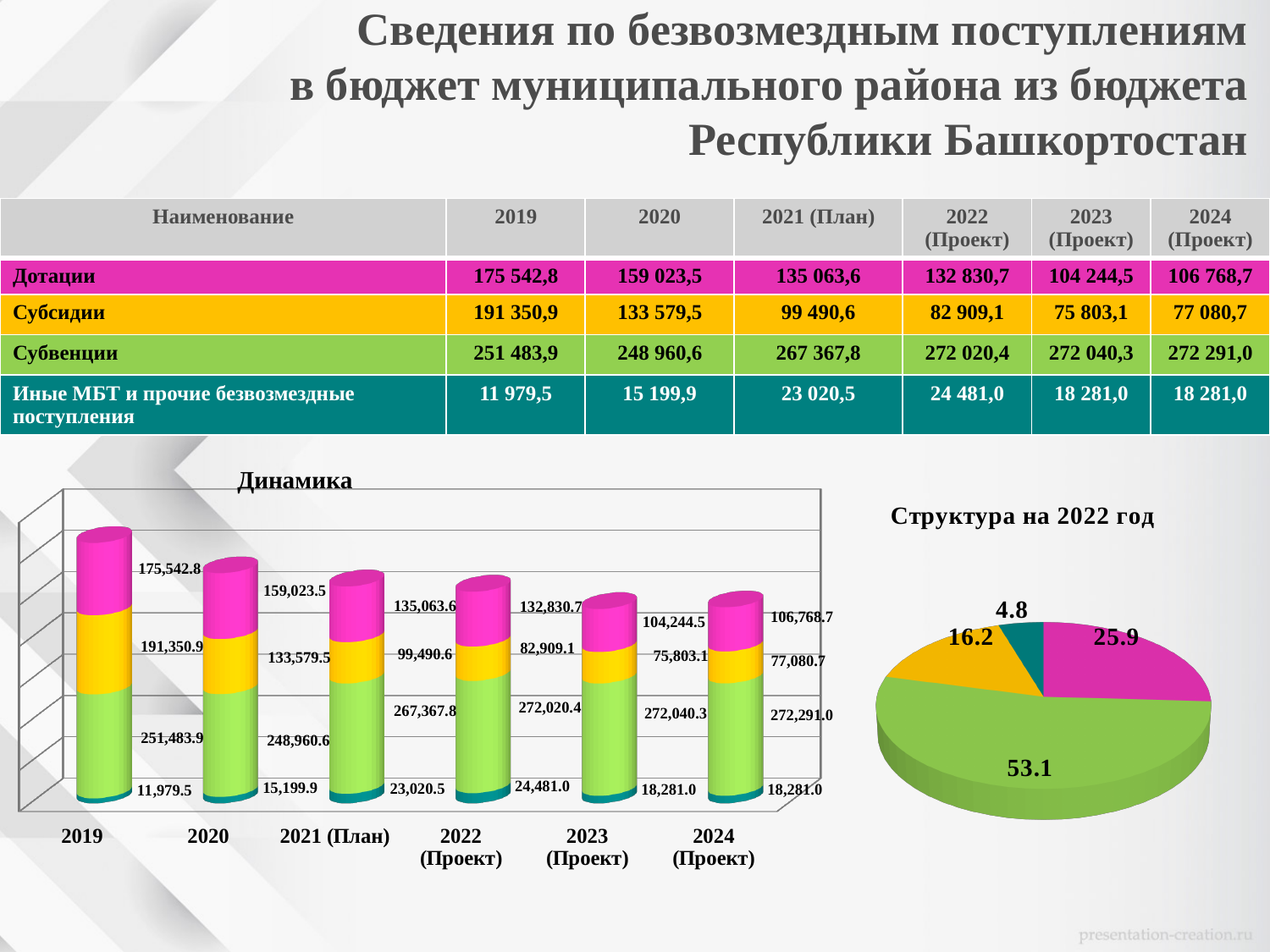
In the "Структура на 2022 год" pie chart, what is the value of the largest slice? 53.1 In the "Динамика" chart, what is the difference between the pink segment values for 2019 and 2020? 16,519.3 In the "Динамика" chart, what is the total of the stacked bar for 2022 (Проект)? 512,241.2 In the "Динамика" chart, which year has the largest pink (top) segment? 2019 What kind of chart is the "Динамика" chart? bar chart In the "Структура на 2022 год" pie chart, what is the value of the smallest slice? 4.8 In the "Динамика" chart, what is the value of the green segment for 2024 (Проект)? 272,291.0 In the "Динамика" chart, what is the value of the pink (top) segment for 2019? 175,542.8 In the "Динамика" chart, does the yellow segment rise or fall from 2019 to 2023 (Проект)? fall In the "Динамика" chart, is the yellow segment larger for 2019 or for 2020? 2019 What kind of chart is the "Структура на 2022 год" chart? pie chart In the "Динамика" chart, how many year categories are shown on the x axis? 6